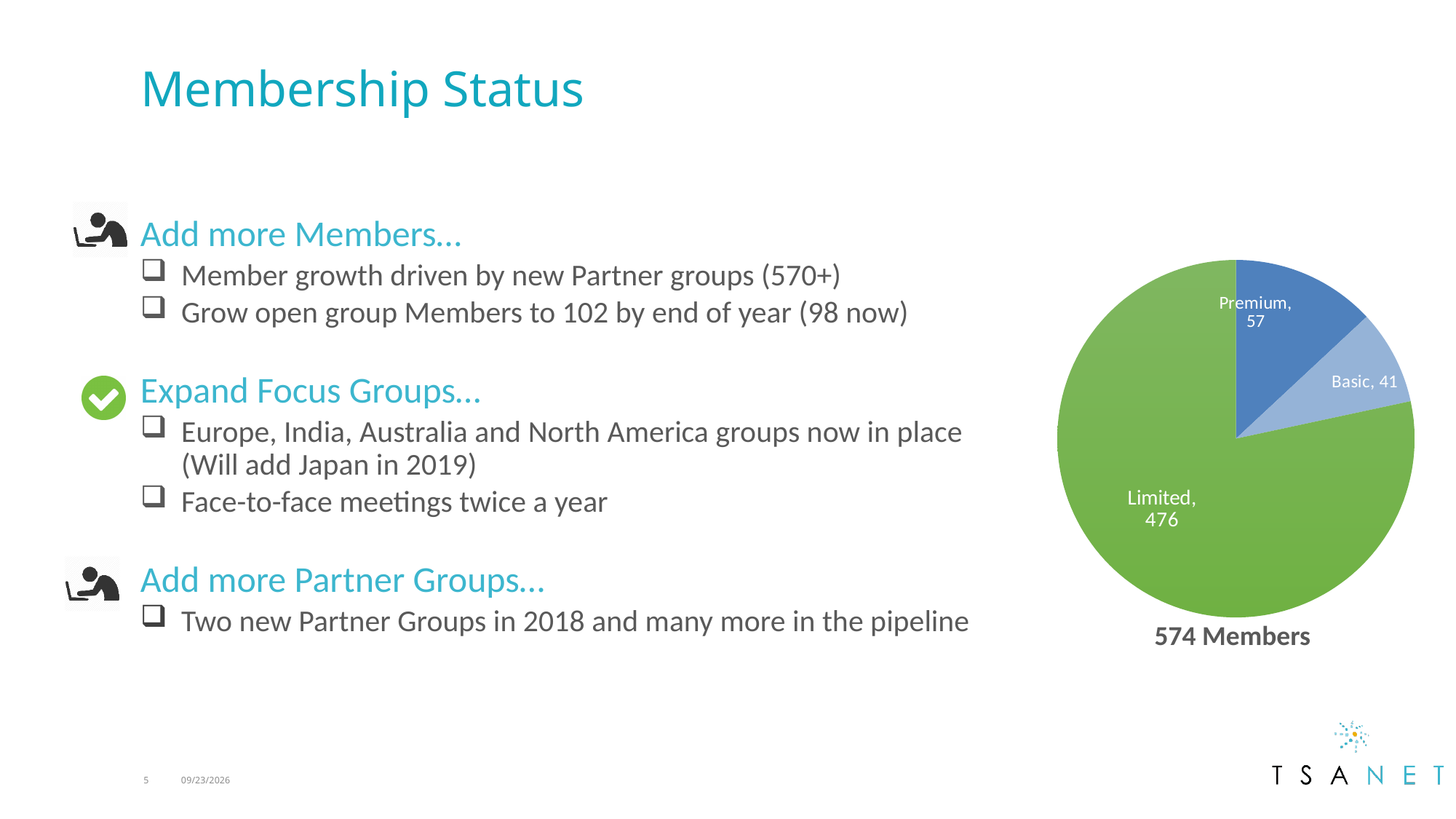
What type of chart is shown on the slide? Pie chart How many slices does the pie chart have? 3 Which is larger in the pie chart, Premium or Basic? Premium Which membership category has the largest slice in the pie chart? Limited What is the difference between the Premium and Basic values in the pie chart? 16 What is the value shown for the Premium slice of the pie chart? 57 What is the value shown for the Basic slice of the pie chart? 41 What total number of members is stated below the pie chart? 574 Members What is the difference between the Limited and Premium values in the pie chart? 419 Which membership category has the smallest slice in the pie chart? Basic What colour is the Limited slice in the pie chart? Green How many members are in the Limited category in the pie chart? 476